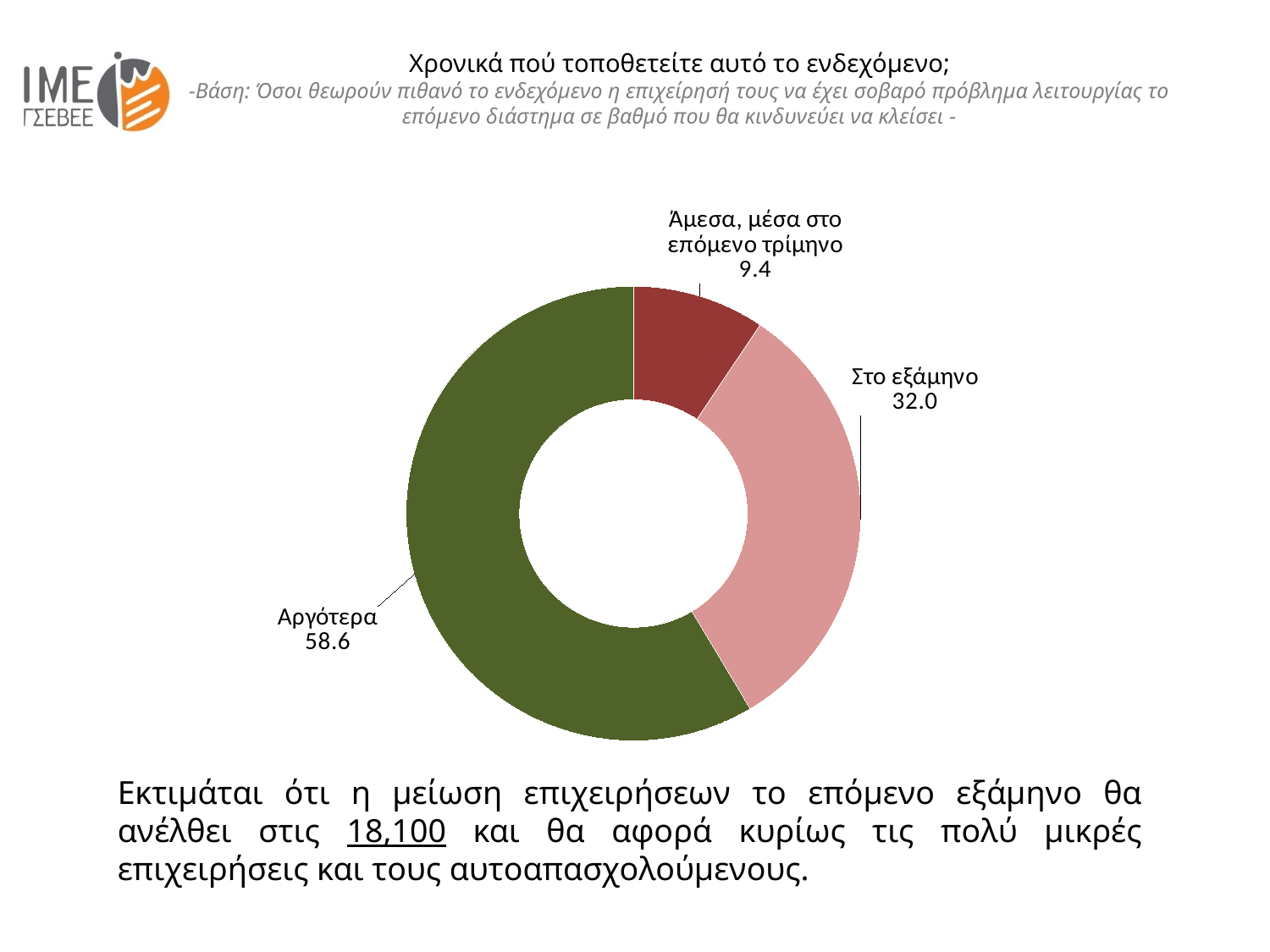
What value is shown for the slice "Στο εξάμηνο"? 32.0 Which category has the smallest slice in the chart? Άμεσα, μέσα στο επόμενο τρίμηνο What value is shown for the slice "Αργότερα"? 58.6 What kind of chart is shown on the slide? Doughnut (pie) chart Which category has the largest slice in the chart? Αργότερα What share of the chart does the slice "Αργότερα" represent? 58.6 What is the difference between the values for "Αργότερα" and "Στο εξάμηνο"? 26.6 How many categories (slices) does the chart show? 3 What is the title of the chart on the slide? Χρονικά πού τοποθετείτε αυτό το ενδεχόμενο; Which is larger, the value for "Στο εξάμηνο" or the value for "Άμεσα, μέσα στο επόμενο τρίμηνο"? Στο εξάμηνο What value is shown for the slice "Άμεσα, μέσα στο επόμενο τρίμηνο"? 9.4 What is the difference between the values for "Στο εξάμηνο" and "Άμεσα, μέσα στο επόμενο τρίμηνο"? 22.6